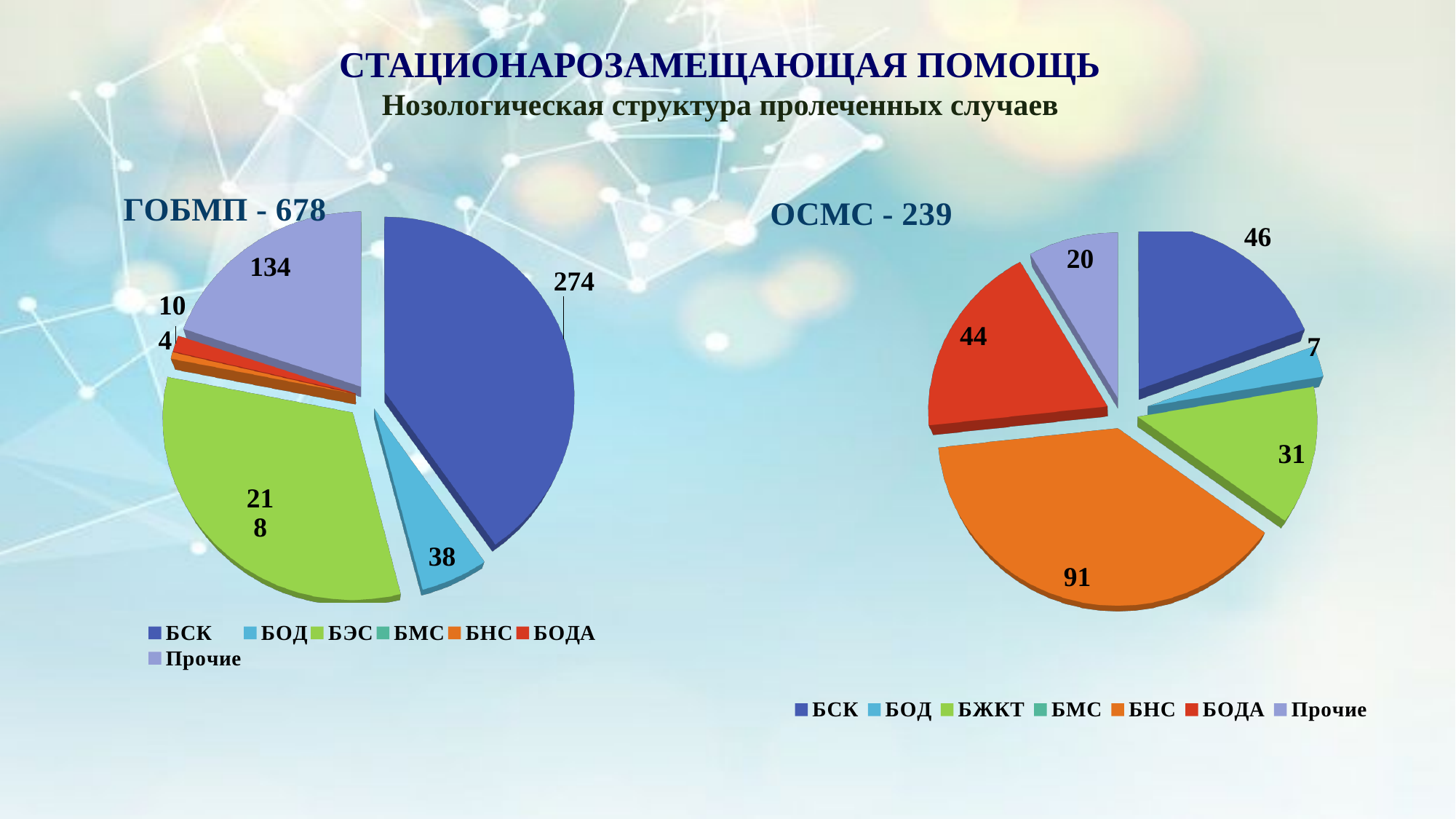
In the ГОБМП - 678 pie chart, which category has the largest slice? БСК In the ГОБМП - 678 pie chart, what is the value for БСК? 274 In the ГОБМП - 678 pie chart, what is the value for БОД? 38 How many entries does the legend of the ОСМС - 239 chart list? 7 In the ОСМС - 239 pie chart, which is larger, БСК or БЖКТ? БСК In the ГОБМП - 678 pie chart, what is the value for Прочие? 134 In the ОСМС - 239 pie chart, what is the difference between the БНС value and the Прочие value? 71 What type of chart is used for ГОБМП - 678? Pie chart In the ОСМС - 239 pie chart, what is the value for БНС? 91 In the ОСМС - 239 pie chart, which category has the smallest labelled slice? БОД In the ГОБМП - 678 pie chart, what is the difference between the БСК value and the БЭС value? 56 In the ОСМС - 239 pie chart, what is the value for БОДА? 44